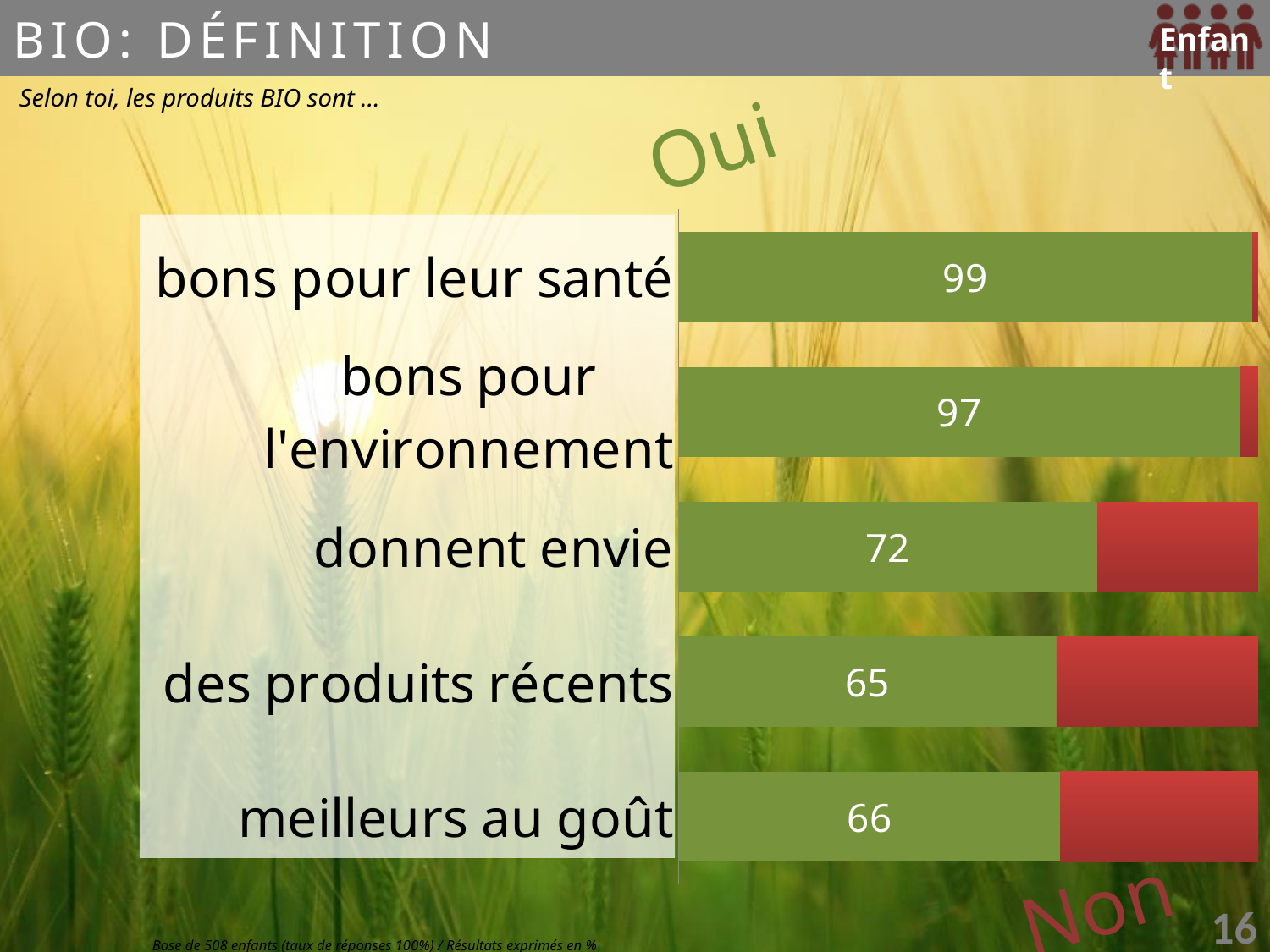
What response does the green portion of each bar represent? Oui How many statements are shown in the chart? 5 Which statement has the highest 'Oui' value? bons pour leur santé What is the 'Oui' value for 'bons pour l'environnement'? 97 Which statement has the lowest 'Oui' value? des produits récents What type of chart is shown on the slide? bar chart What is the 'Oui' value for 'meilleurs au goût'? 66 What is the 'Oui' value for 'des produits récents'? 65 What is the difference between the 'Oui' values for 'bons pour leur santé' and 'donnent envie'? 27 What percentage of children say BIO products are 'bons pour leur santé'? 99 What is the 'Oui' value for 'donnent envie'? 72 Which has a larger 'Oui' value: 'meilleurs au goût' or 'des produits récents'? meilleurs au goût